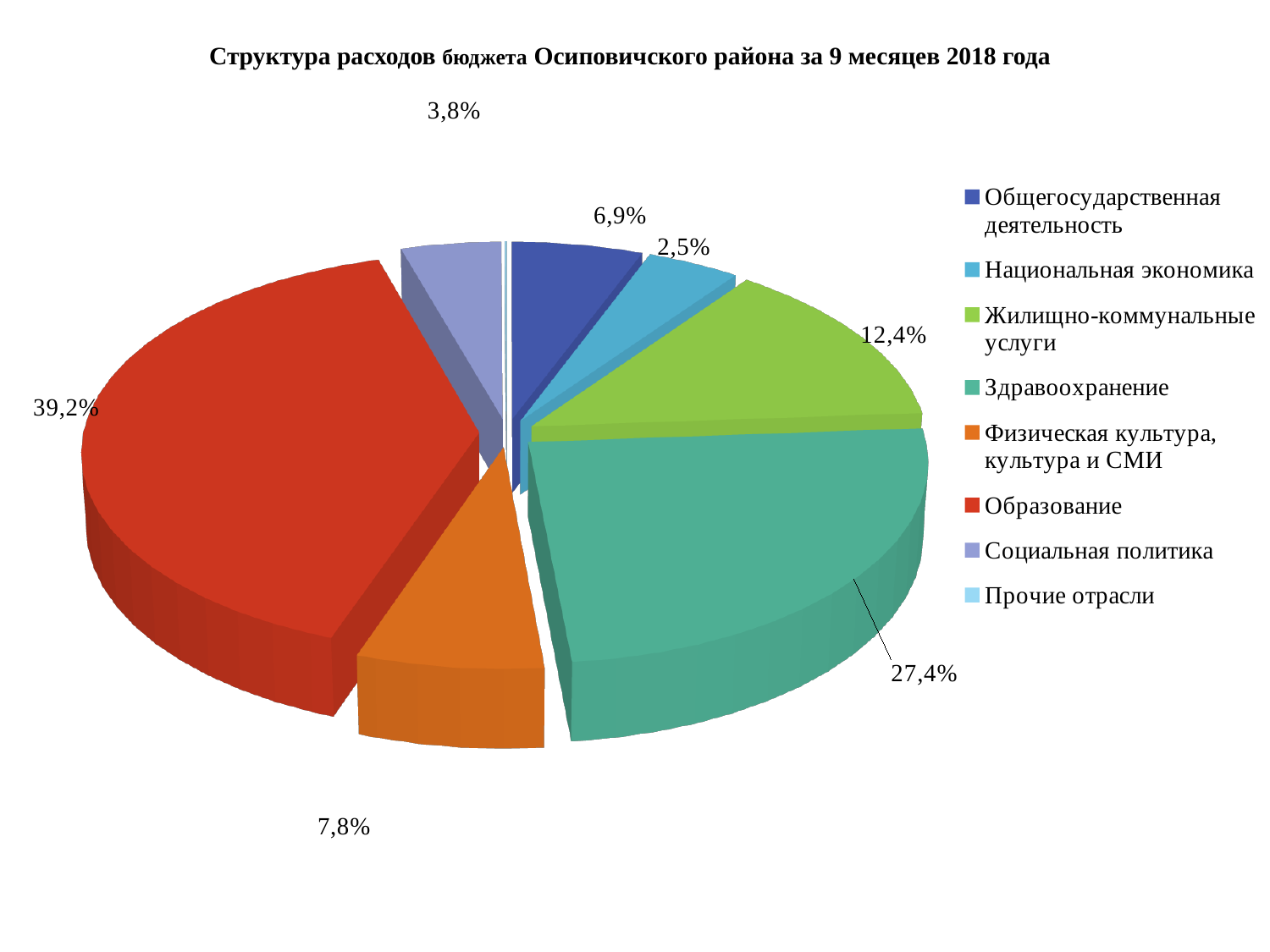
What share of expenditure does Образование account for? 39,2% What share of expenditure does Жилищно-коммунальные услуги account for? 12,4% What is the title of the chart? Структура расходов бюджета Осиповичского района за 9 месяцев 2018 года What share of expenditure does Здравоохранение account for? 27,4% What share of expenditure does Национальная экономика account for? 2,5% What type of chart is shown on the slide? Pie chart Which has a larger share, Общегосударственная деятельность or Физическая культура, культура и СМИ? Физическая культура, культура и СМИ How many categories does the legend list? 8 What is the difference between the shares of Образование and Здравоохранение? 11,8% What share of expenditure does Физическая культура, культура и СМИ account for? 7,8% What share of expenditure does Социальная политика account for? 3,8% Which category has the largest share of expenditure? Образование